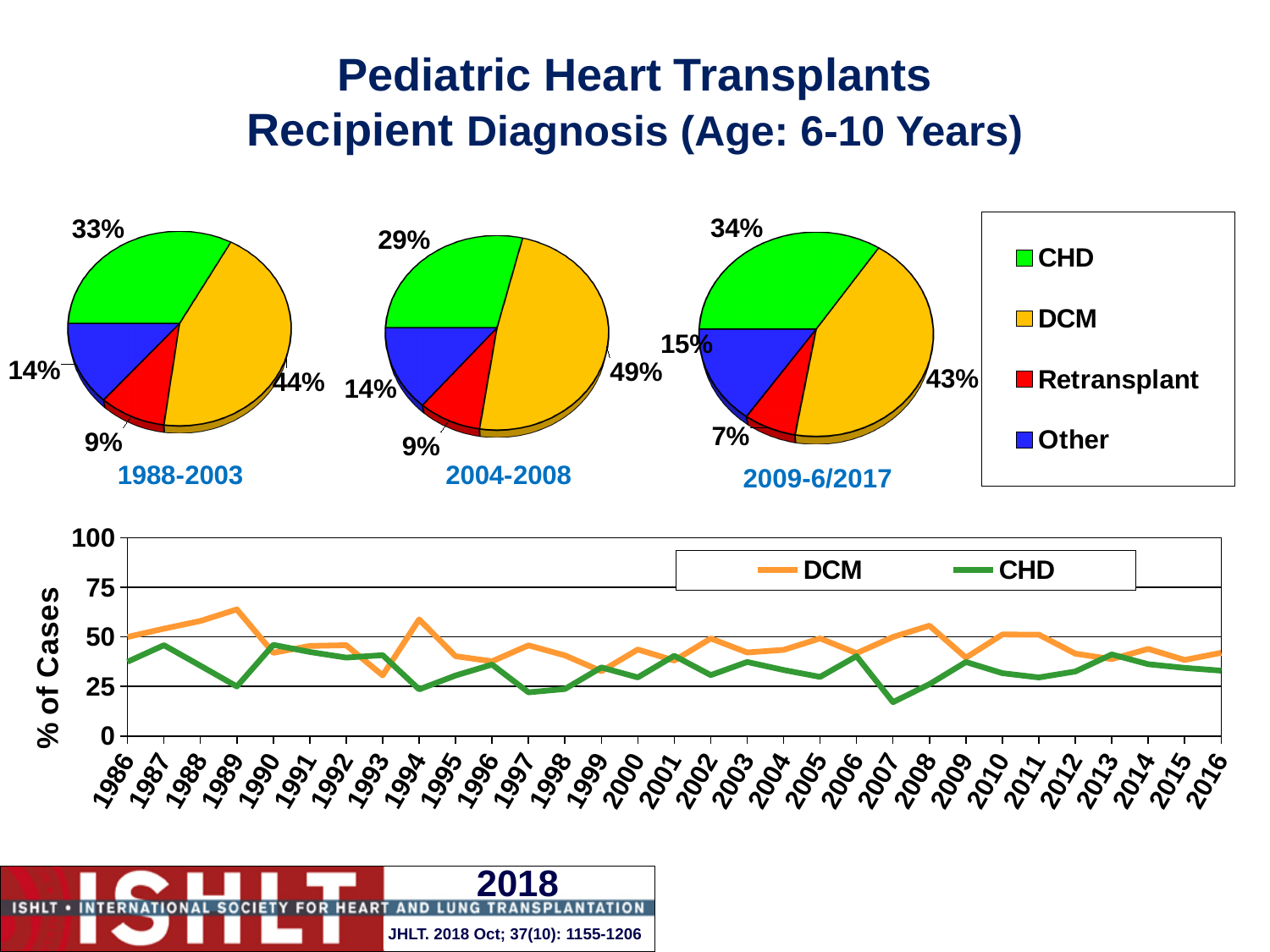
In the 2009-6/2017 pie chart, what percentage of cases is Retransplant? 7% In the bottom line chart, is the DCM value for 1989 greater or less than 50? greater In the 2004-2008 pie chart, what is the difference between the DCM and CHD shares? 20% In the 2004-2008 pie chart, which diagnosis has the smallest share? Retransplant In the 2009-6/2017 pie chart, which diagnosis has the largest share? DCM How many series does the legend of the bottom line chart list? 2 What kind of chart is the bottom chart showing % of Cases by year? Line chart In the 2004-2008 pie chart, what percentage of cases is CHD? 29% In the bottom line chart, is the CHD value for 2007 greater or less than 25? less In the 1988-2003 pie chart, what percentage of cases is DCM? 44% In the 1988-2003 pie chart, which is larger, the Other share or the Retransplant share? Other How many diagnosis categories does the pie chart legend list? 4